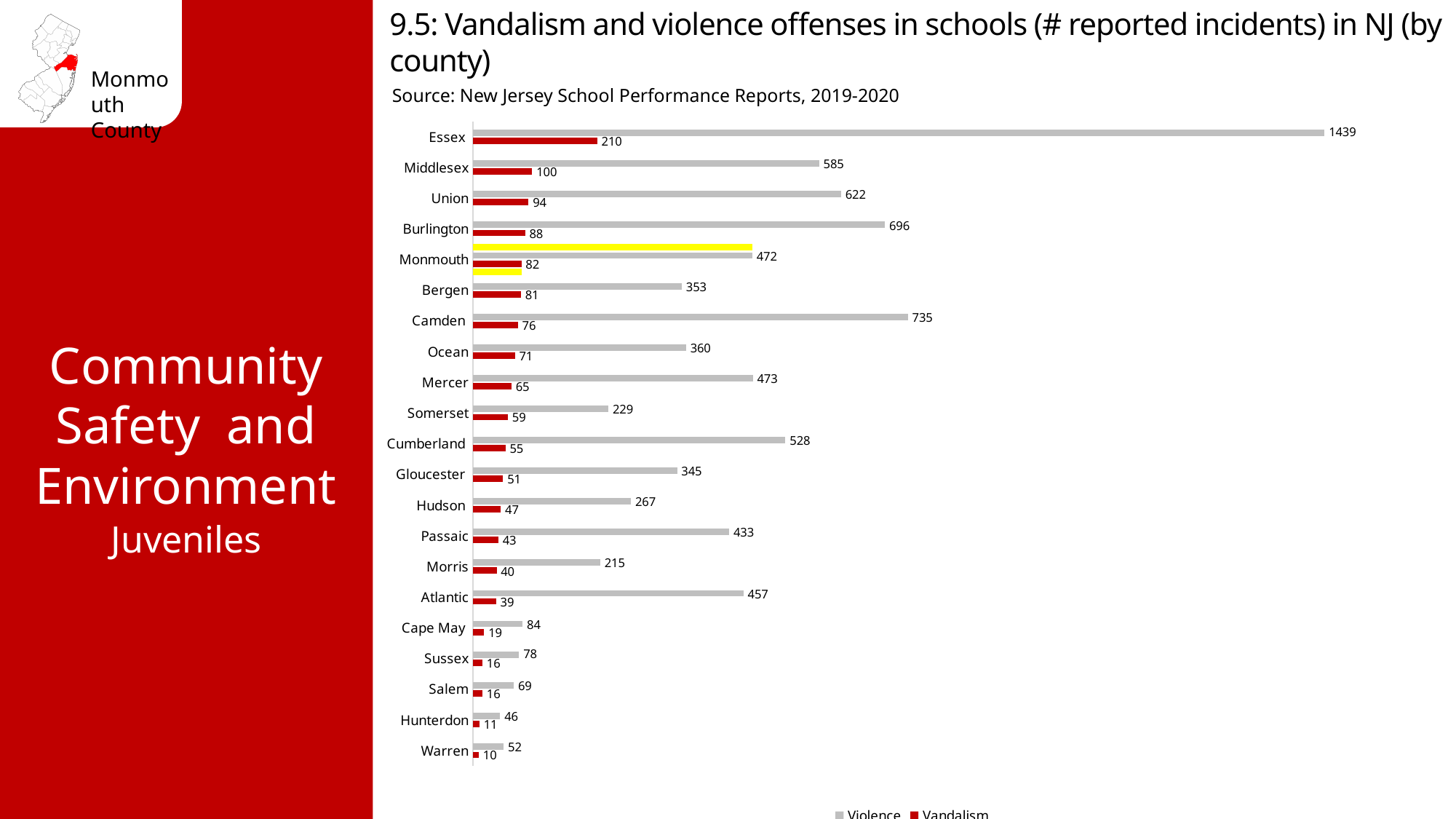
What kind of chart is shown on the slide? Bar chart Which county has more reported violence incidents, Union or Middlesex? Union How many series does the legend list? 2 Which county has the lowest number of reported vandalism incidents? Warren Which county has the highest number of reported violence incidents? Essex What is the number of reported vandalism incidents for Hunterdon County? 11 What is the difference between the violence incidents in Camden and Burlington? 39 Which series is shown in red on the chart? Vandalism What is the difference between the vandalism incidents in Essex and Middlesex? 110 How many counties are shown on the chart? 21 What is the number of reported vandalism incidents for Essex County? 210 What is the number of reported violence incidents for Monmouth County? 472